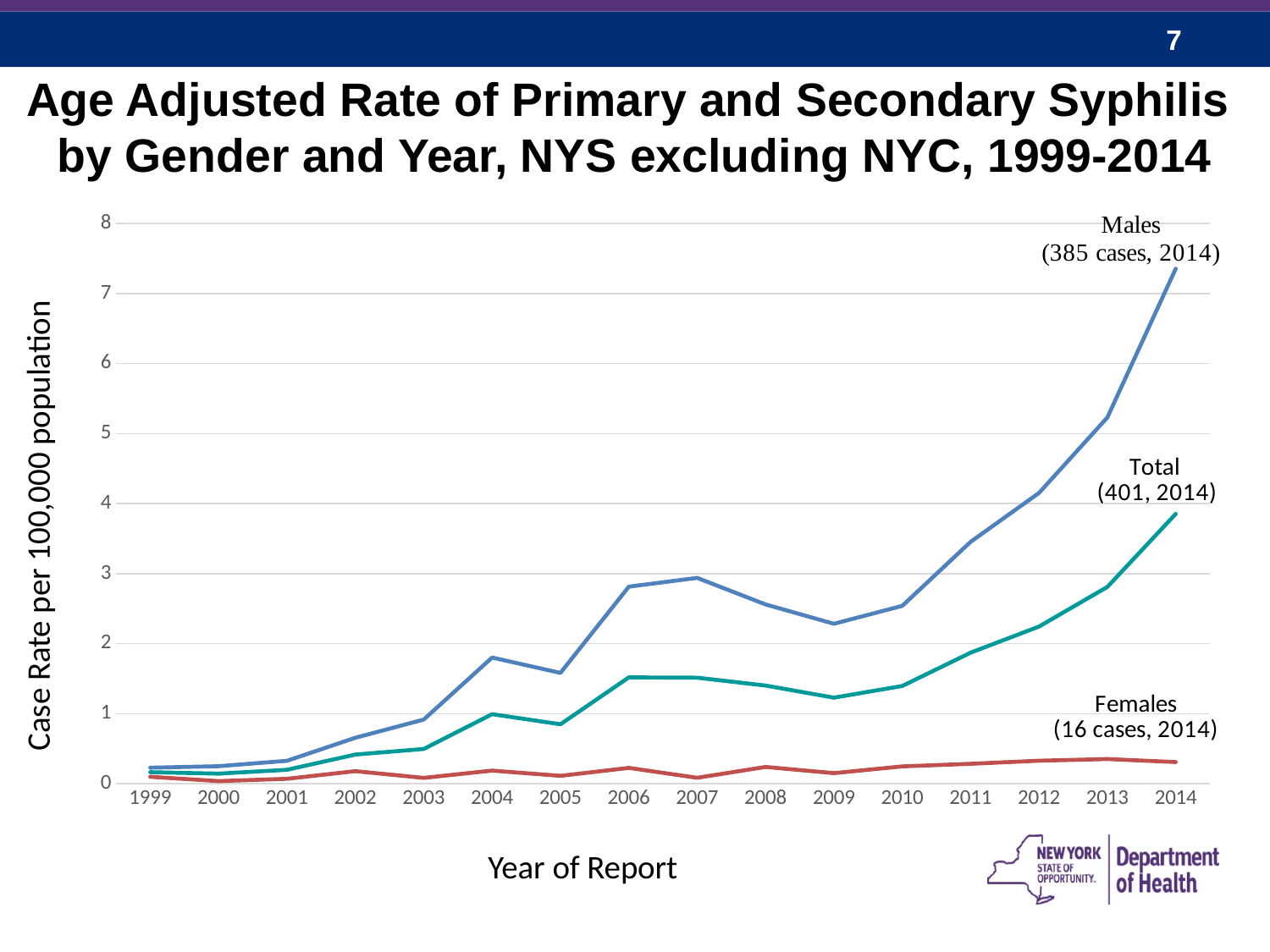
Is the Total rate in 2014 greater or less than 4? less Does the Males rate rise or fall from 2009 to 2014? rise Is the Males rate in 2014 greater or less than 7? greater What is the Total number of cases noted for 2014? 401 How many series are plotted on the chart? 3 Is the Females rate in 2014 greater or less than 1? less What is the label of the y axis? Case Rate per 100,000 population How many cases are noted for Females in 2014? 16 cases How many years are shown along the x axis? 16 How many cases are noted for Males in 2014? 385 cases What kind of chart is shown on the slide? line chart Which series has the highest rate in 2014? Males